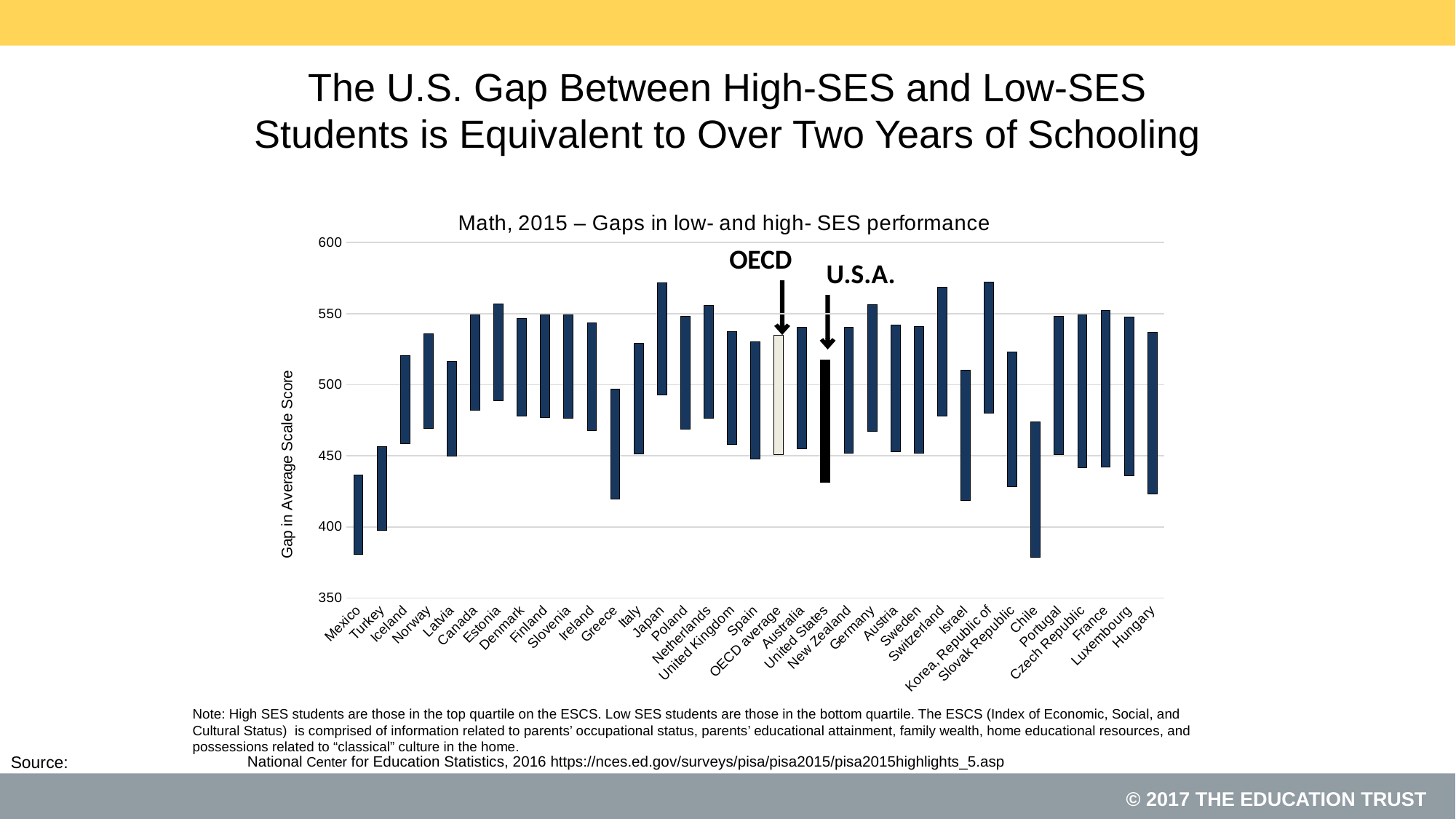
Is the upper end of the bar for Israel greater or less than 500? greater Which has the higher upper end of its bar, Japan or Mexico? Japan Is the upper end of the bar for Japan greater or less than 550? greater Is the upper end of the bar for Mexico greater or less than 450? less What is the title of the chart? Math, 2015 – Gaps in low- and high- SES performance How many countries or groups are shown along the x axis of the chart? 35 What kind of chart is shown on the slide? Bar chart What is the label on the vertical axis of the chart? Gap in Average Scale Score